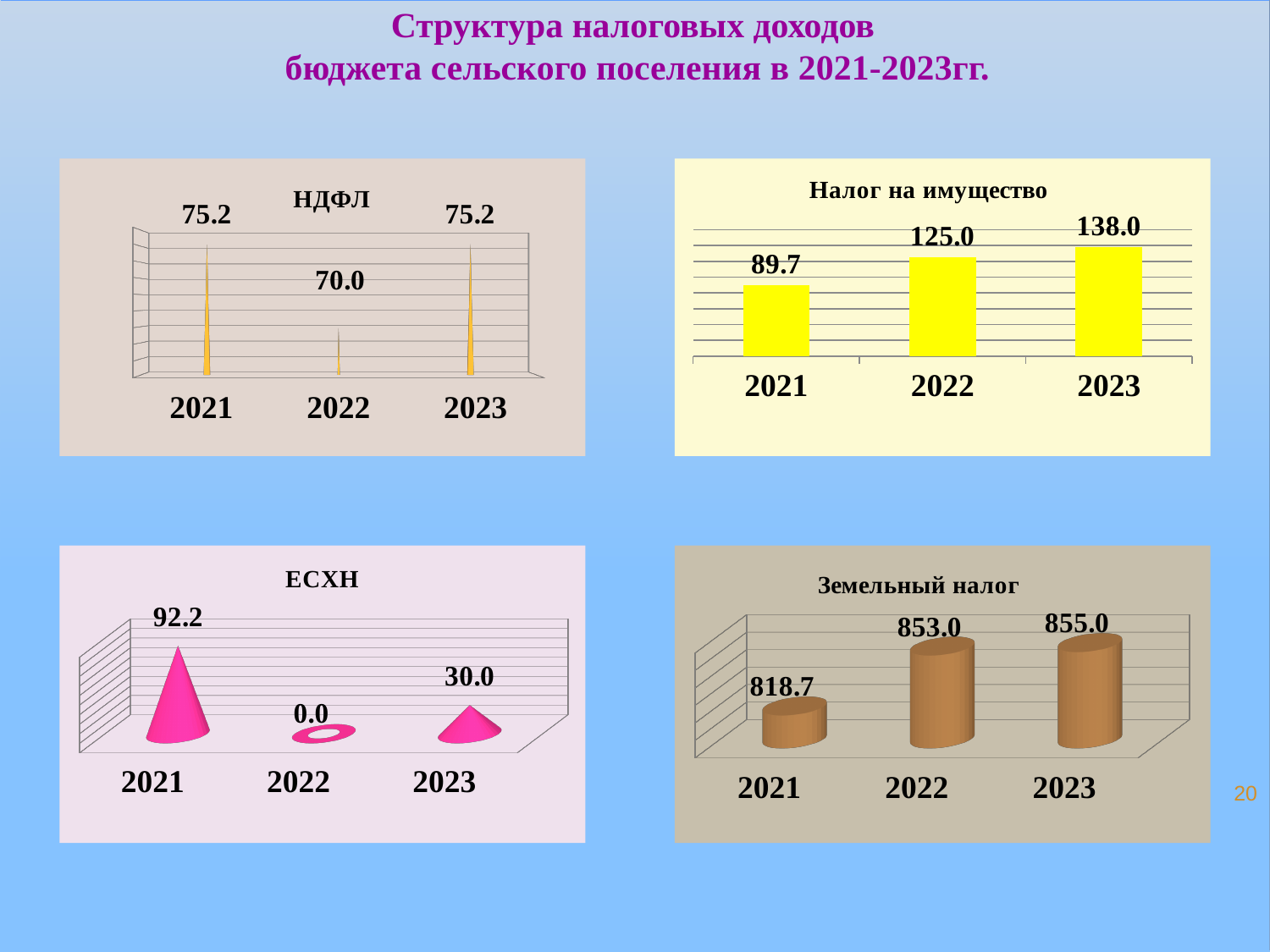
In the 'ЕСХН' chart, which year has the lowest value? 2022 How many years are shown in the 'Земельный налог' chart? 3 In the 'НДФЛ' chart, which year has the lowest value? 2022 In the 'Налог на имущество' chart, what is the difference between the 2023 and 2021 values? 48.3 In the 'Земельный налог' chart, what is the difference between the 2023 and 2022 values? 2.0 In the 'Налог на имущество' chart, which year has the highest value? 2023 In the 'ЕСХН' chart, what is the value for 2023? 30.0 In the 'ЕСХН' chart, which is larger, the value for 2021 or the value for 2023? 2021 In the 'НДФЛ' chart, what is the value for 2022? 70.0 In the 'Земельный налог' chart, what is the value for 2021? 818.7 In the 'Налог на имущество' chart, do the values rise or fall from 2021 to 2023? rise In the 'Налог на имущество' chart, what is the value for 2022? 125.0